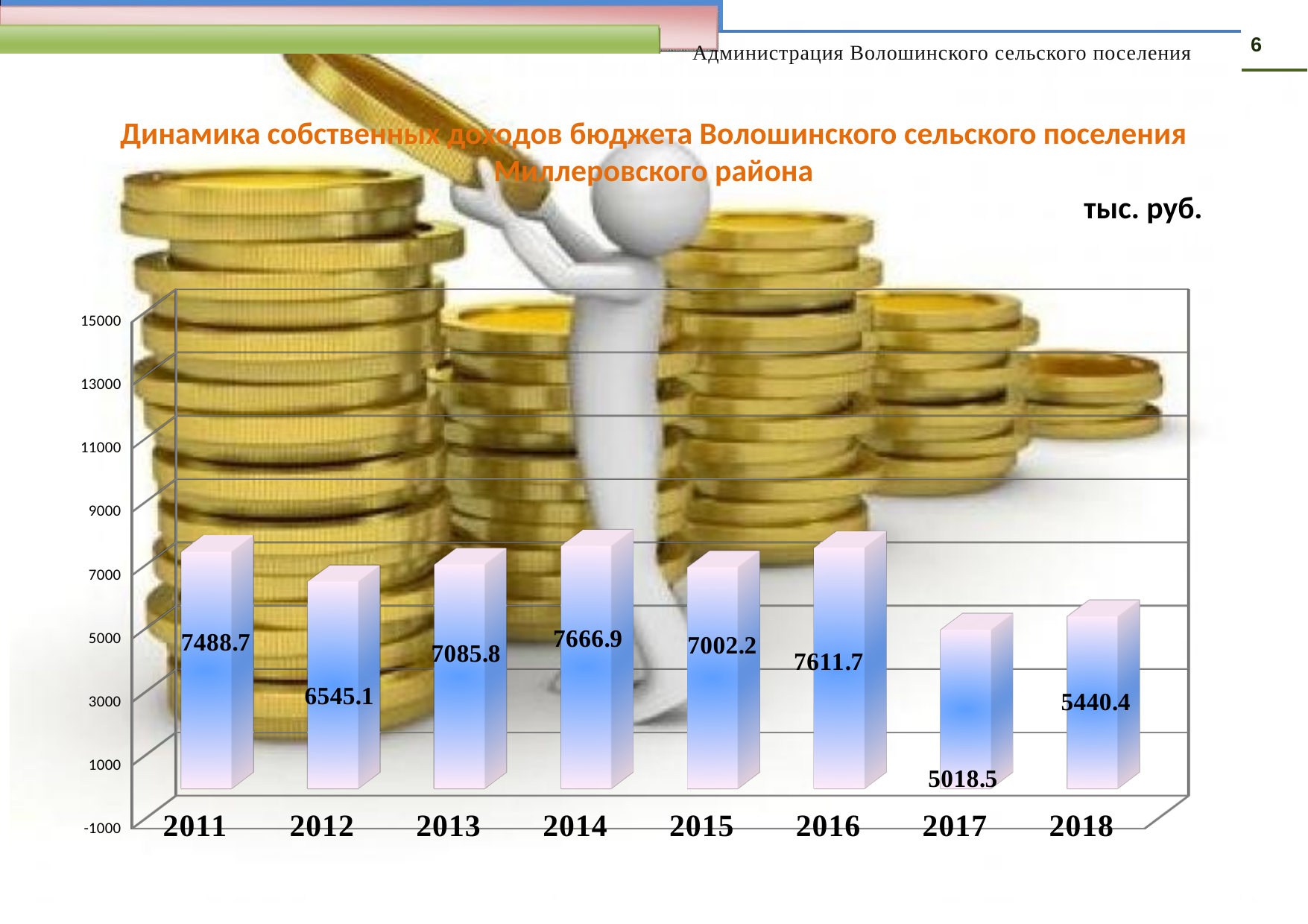
What is the value for 2012? 6545.1 What is the value for 2017? 5018.5 Which year has the highest value? 2014 Do the values rise or fall from 2016 to 2017? fall Is the value for 2018 greater or less than 7000? less What unit is indicated for the chart values? тыс. руб. What is the difference between the values for 2011 and 2012? 943.6 Which is larger, the value for 2016 or the value for 2015? 2016 How many years are shown on the x axis? 8 What kind of chart is shown on the slide? bar chart Which year has the lowest value? 2017 What is the value for 2014? 7666.9